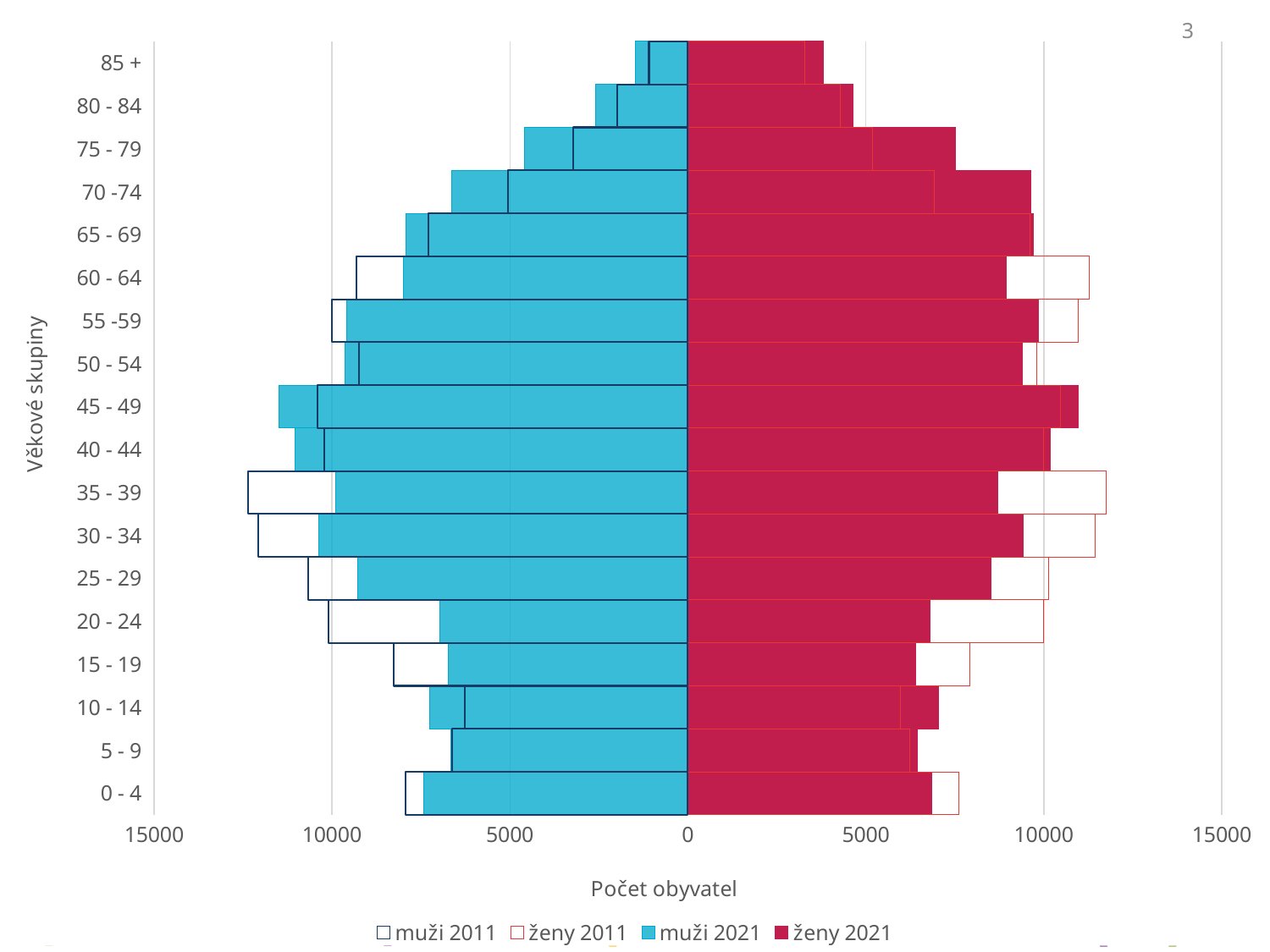
Is the value for ženy 2021 in the 0 - 4 age group greater or less than 5000? greater Which age group has the highest value for muži 2021? 45 - 49 Which age group has the lowest value for ženy 2021? 85 + What kind of chart is shown on the slide? bar chart What is the title of the horizontal axis? Počet obyvatel For the 20 - 24 age group, which is larger: muži 2011 or muži 2021? muži 2011 For the 70 -74 age group, which is larger: ženy 2011 or ženy 2021? ženy 2021 How many series does the legend list? 4 How many age groups are shown on the vertical axis? 18 Is the value for ženy 2011 in the 60 - 64 age group greater or less than 10000? greater Is the value for muži 2021 in the 20 - 24 age group greater or less than 10000? less